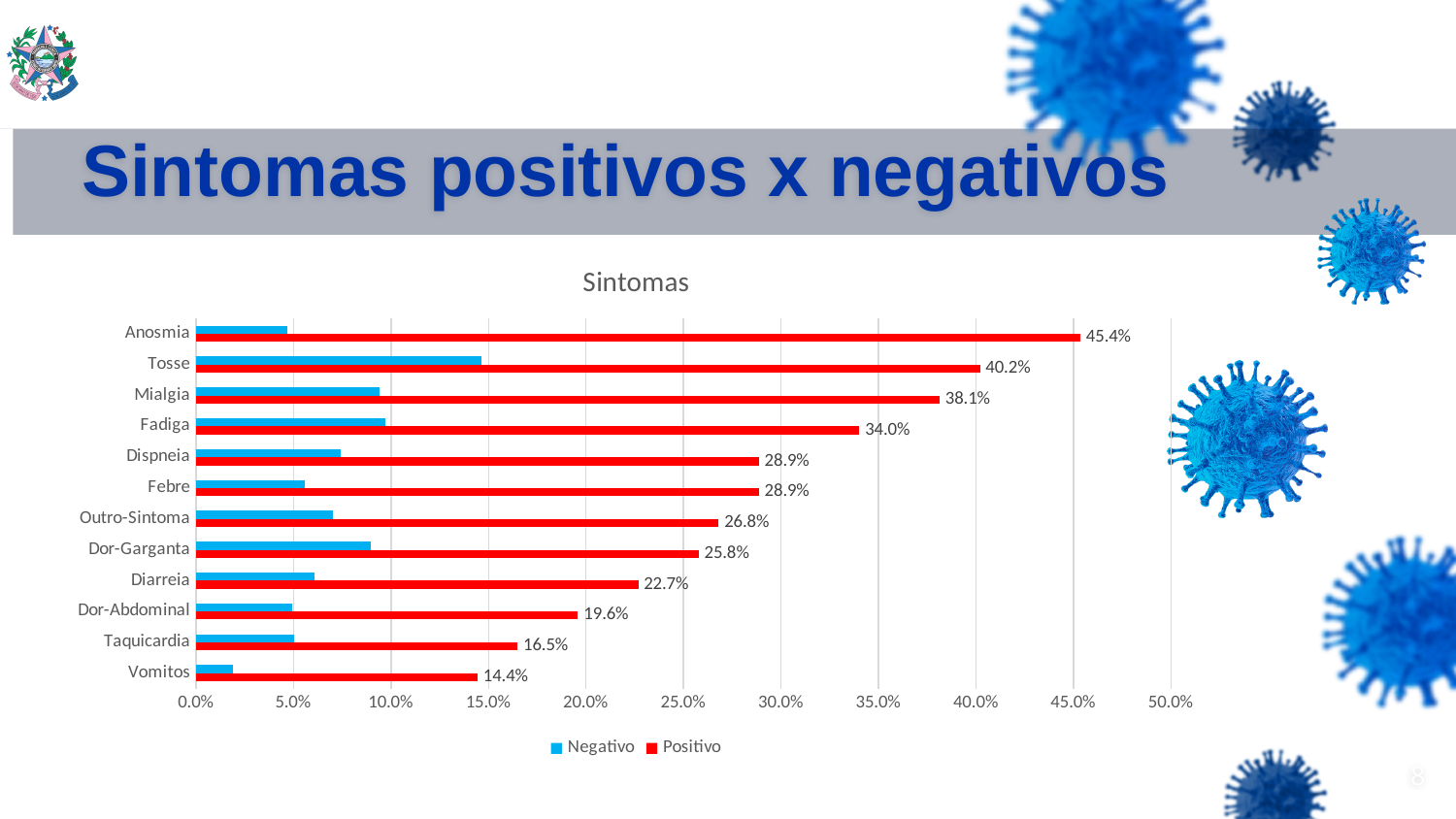
What is the Positivo value for Dor-Garganta? 25.8% What is the Positivo value for Anosmia? 45.4% How many symptom categories are shown in the chart? 12 What is the difference between the Positivo values for Tosse and Mialgia? 2.1% Which symptom has the highest Positivo value? Anosmia Is the Negativo value for Vomitos greater or less than 5.0%? less What is the Positivo value for Vomitos? 14.4% Which symptom has the lowest Positivo value? Vomitos Which has a larger Positivo value, Diarreia or Dor-Abdominal? Diarreia What type of chart is shown on the slide? bar chart Is the Negativo value for Tosse greater or less than 10.0%? greater How many series does the legend list? 2